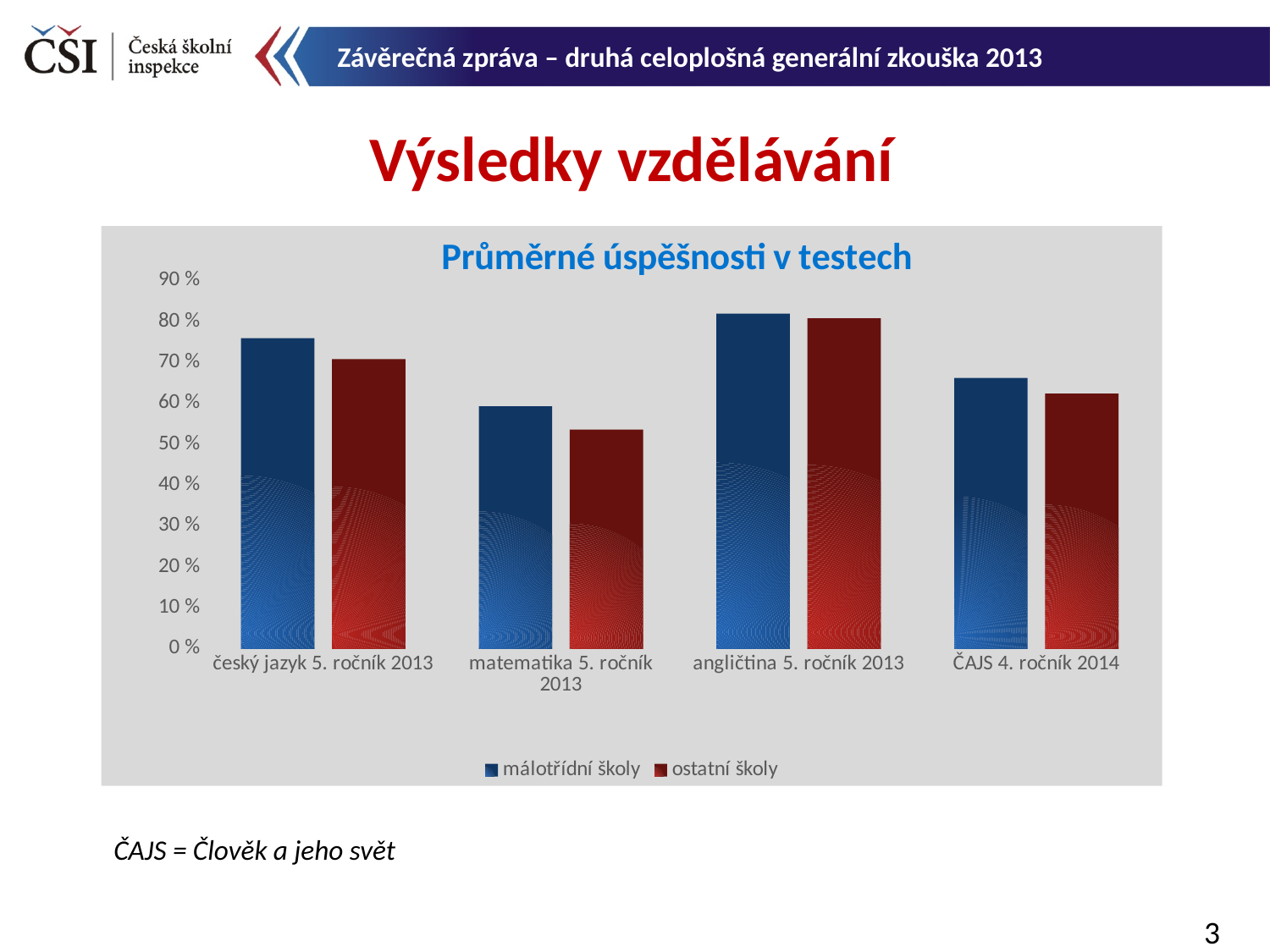
Which series is shown in blue in the legend? málotřídní školy What kind of chart is shown on the slide? bar chart Which category has the highest value for málotřídní školy? angličtina 5. ročník 2013 How many categories are shown on the x axis? 4 Is the value for málotřídní školy in český jazyk 5. ročník 2013 greater or less than 70 %? greater Which category has the lowest value for ostatní školy? matematika 5. ročník 2013 Is the value for ostatní školy in matematika 5. ročník 2013 greater or less than 60 %? less In matematika 5. ročník 2013, which series has the larger value, málotřídní školy or ostatní školy? málotřídní školy How many series does the legend list? 2 Is the value for málotřídní školy in angličtina 5. ročník 2013 greater or less than 70 %? greater What is the title of the chart? Průměrné úspěšnosti v testech